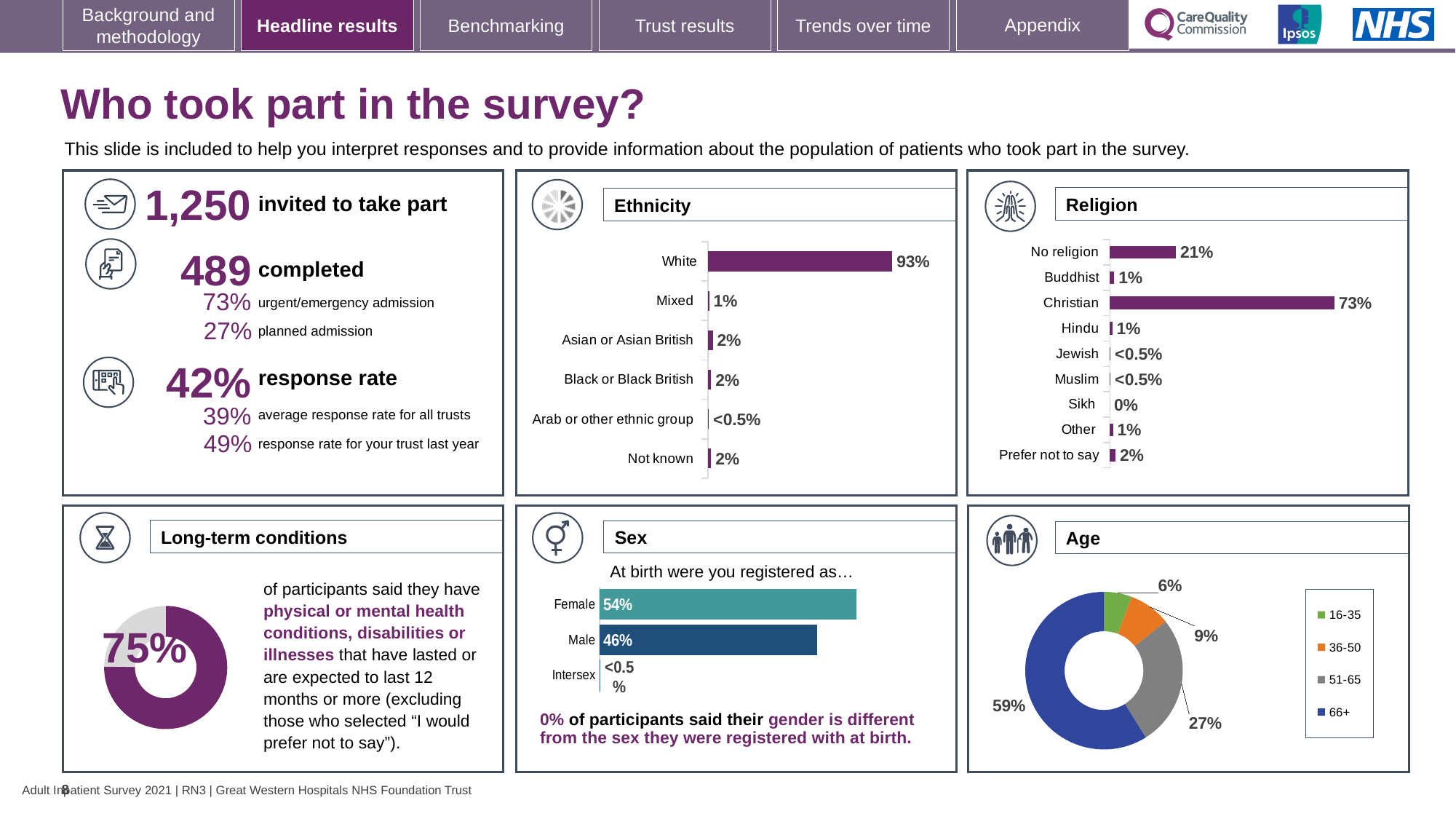
In the Religion chart, what is the value for Christian? 73% In the Sex chart, which is larger, Female or Male? Female In the Sex chart, what percentage of participants were registered as Female at birth? 54% In the Ethnicity chart, how many ethnic categories are shown? 6 In the Religion chart, which religion category has the highest value? Christian In the Religion chart, how many categories are listed? 9 In the Age chart, what share of participants were aged 66+? 59% In the Religion chart, what is the difference between the Christian and No religion values? 52% In the Age chart, how many age groups does the legend list? 4 In the Age chart, which age group has the smallest share? 16-35 What type of chart is used for the Age breakdown? Donut chart In the Ethnicity chart, what percentage of participants were White? 93%